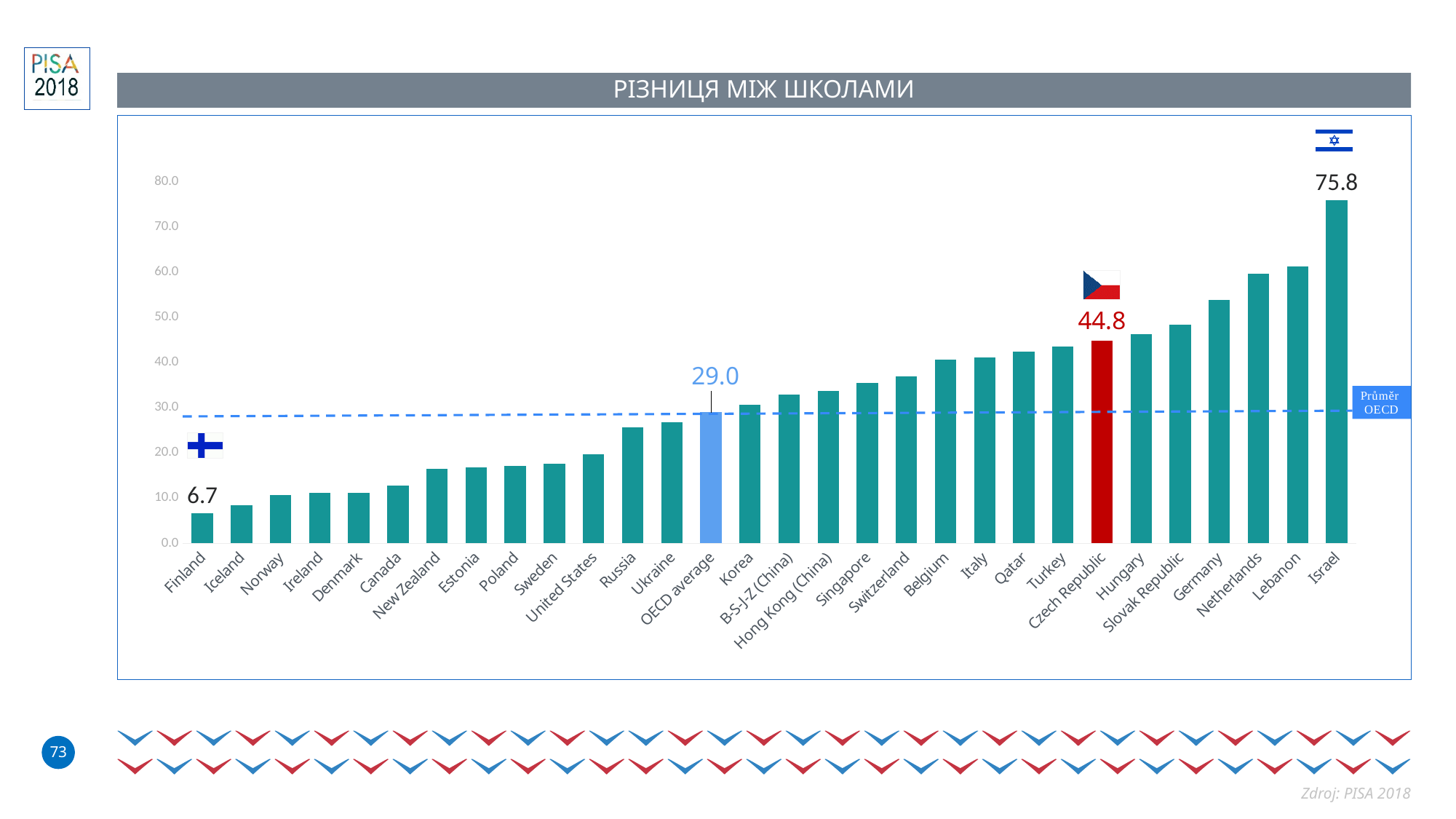
What is the difference between the values for Israel and Finland? 69.1 Is the value for the Netherlands greater or less than 50.0? greater Which has the larger value, Germany or Hungary? Germany What is the value for Israel? 75.8 What is the value for the Czech Republic? 44.8 Do the values rise or fall from left to right along the x axis? rise Which country has the lowest value? Finland Which country has the highest value? Israel How much higher is the Czech Republic's value than the OECD average? 15.8 How many bars are shown in the chart? 30 What is the value for the OECD average? 29.0 What is the value for Finland? 6.7